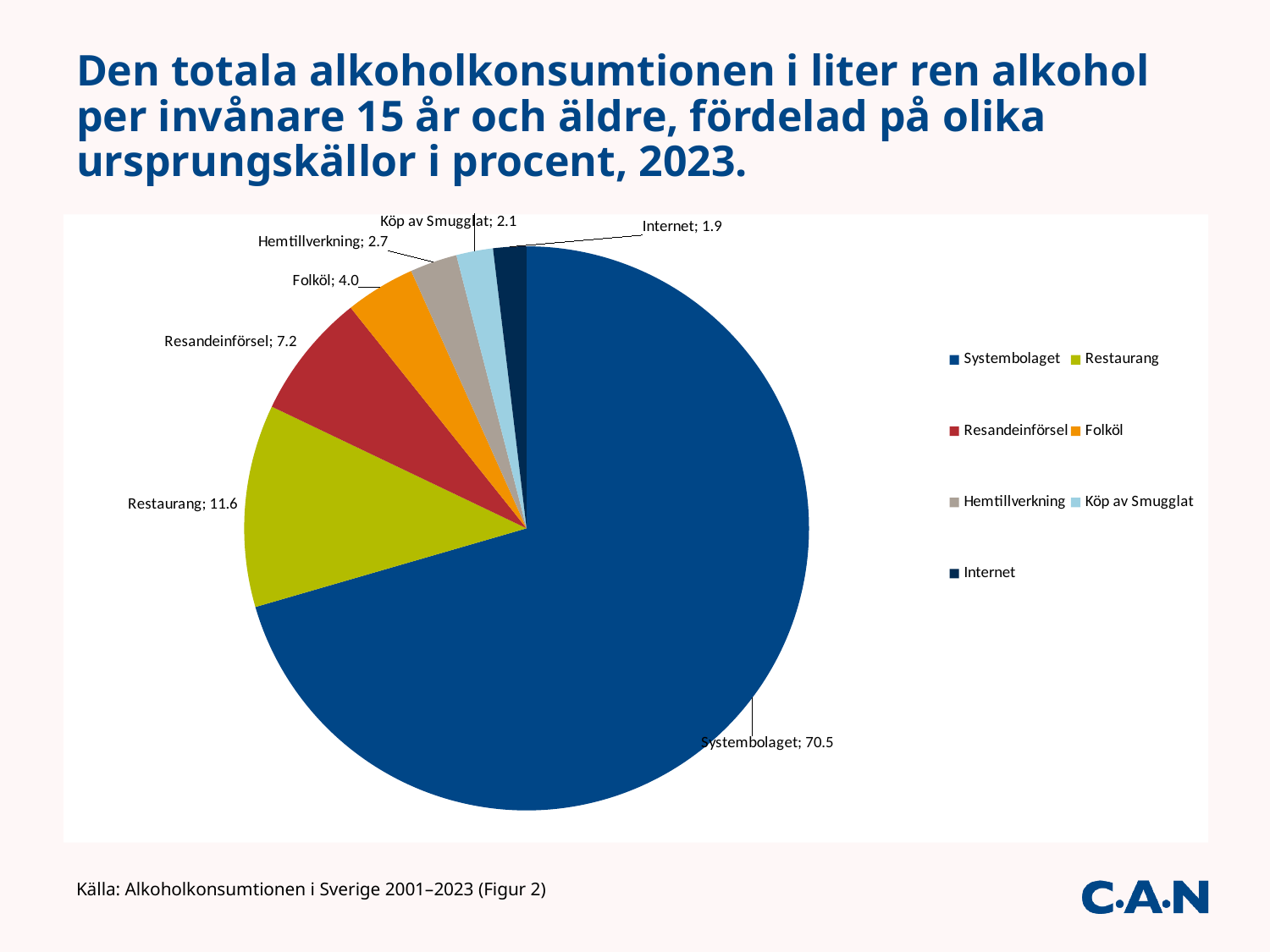
What is the value shown for Systembolaget? 70.5 What colour is the Systembolaget slice? Dark blue What is the value shown for Restaurang? 11.6 How many slices does the pie chart have? 7 What is the value shown for Folköl? 4.0 What is the difference between the values for Restaurang and Resandeinförsel? 4.4 What is the value shown for Hemtillverkning? 2.7 Which category has the smallest slice of the pie? Internet Which category has the largest slice of the pie? Systembolaget What is the value shown for Resandeinförsel? 7.2 What kind of chart is shown on the slide? Pie chart Which is larger, the value for Folköl or the value for Hemtillverkning? Folköl